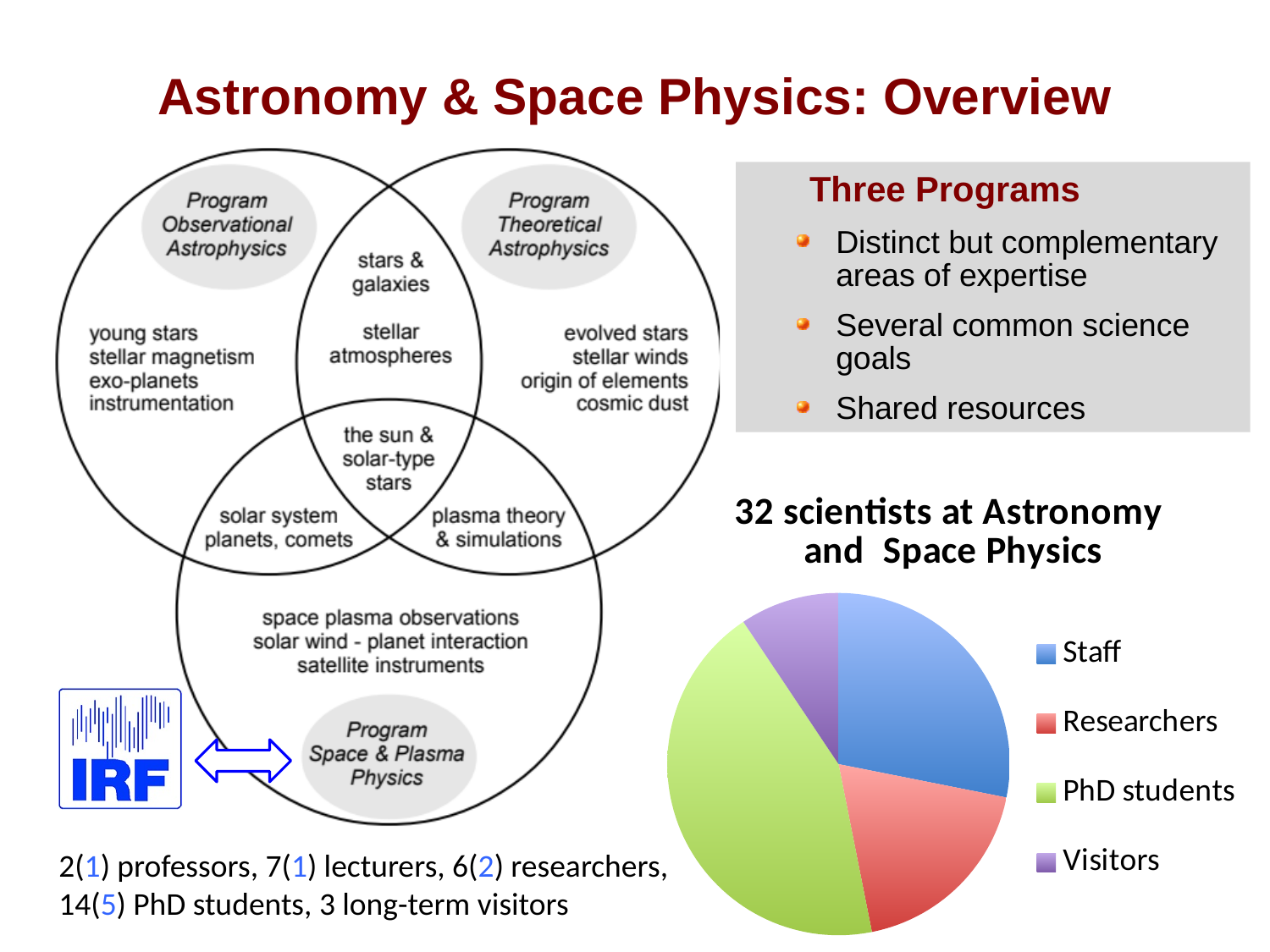
What colour is the PhD students slice in the pie chart? green How many slices does the pie chart have? 4 What kind of chart is shown on the right side of the slide? pie chart In the pie chart, which slice is larger: PhD students or Staff? PhD students How many entries does the legend of the pie chart list? 4 What is the title of the pie chart? 32 scientists at Astronomy and Space Physics In the pie chart, which slice is larger: Staff or Researchers? Staff Which category has the smallest slice in the pie chart? Visitors In the pie chart, which slice is larger: Researchers or Visitors? Researchers Which category has the largest slice in the pie chart? PhD students